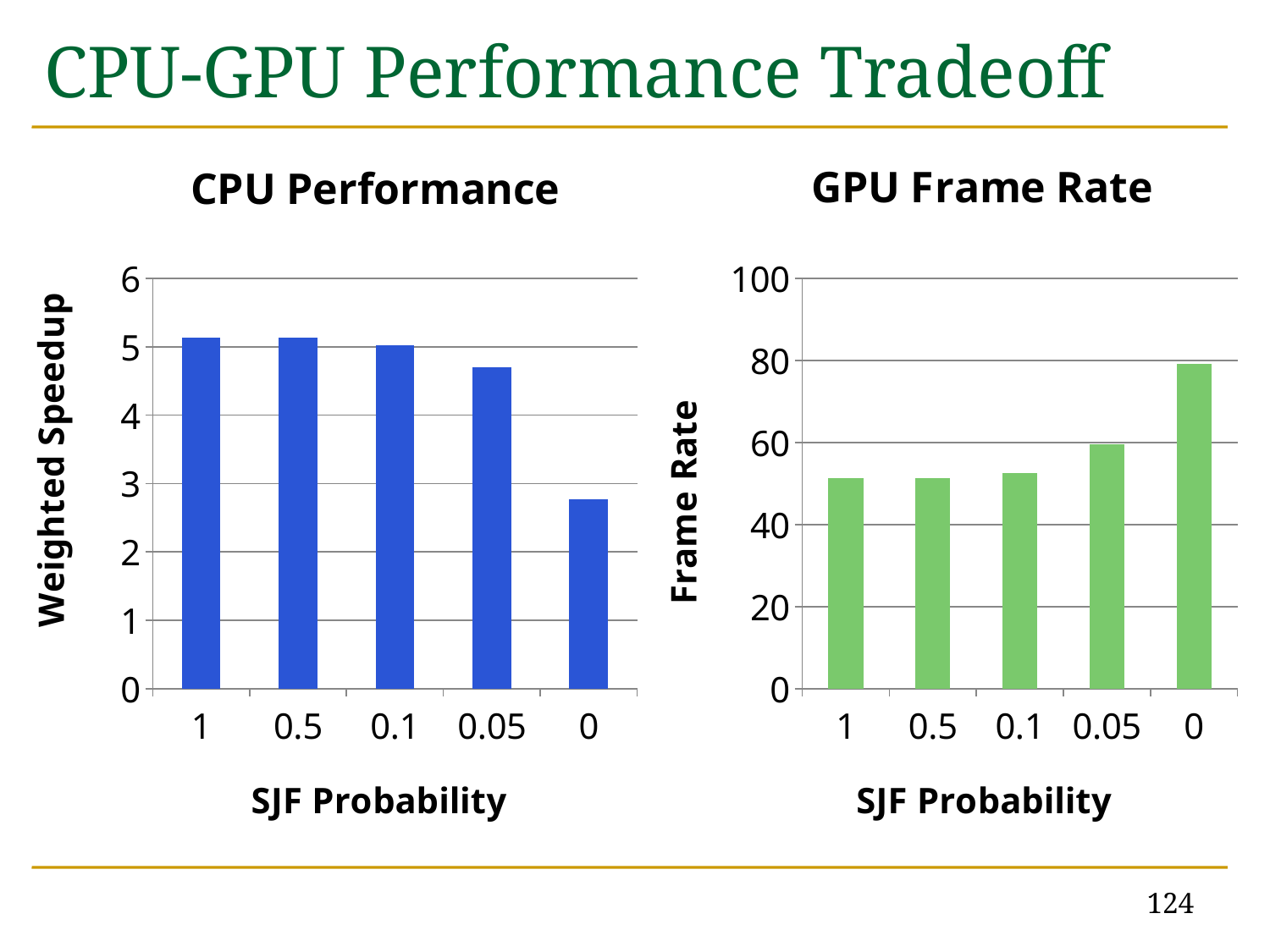
In the GPU Frame Rate chart, does the Frame Rate generally rise or fall as SJF Probability goes from 1 to 0 along the x axis? rise How many SJF Probability categories are shown in the CPU Performance chart? 5 In the GPU Frame Rate chart, is the Frame Rate for SJF Probability 0 greater or less than 60? greater In the GPU Frame Rate chart, which has a larger Frame Rate: SJF Probability 0.05 or SJF Probability 0.1? 0.05 In the CPU Performance chart, which has a larger Weighted Speedup: SJF Probability 0.05 or SJF Probability 0? 0.05 In the CPU Performance chart, is the Weighted Speedup for SJF Probability 0 greater or less than 3? less What is the y-axis label of the CPU Performance chart? Weighted Speedup In the CPU Performance chart, is the Weighted Speedup for SJF Probability 1 greater or less than 5? greater What kind of chart is the GPU Frame Rate chart? bar chart In the GPU Frame Rate chart, which SJF Probability has the highest Frame Rate? 0 In the CPU Performance chart, which SJF Probability has the lowest Weighted Speedup? 0